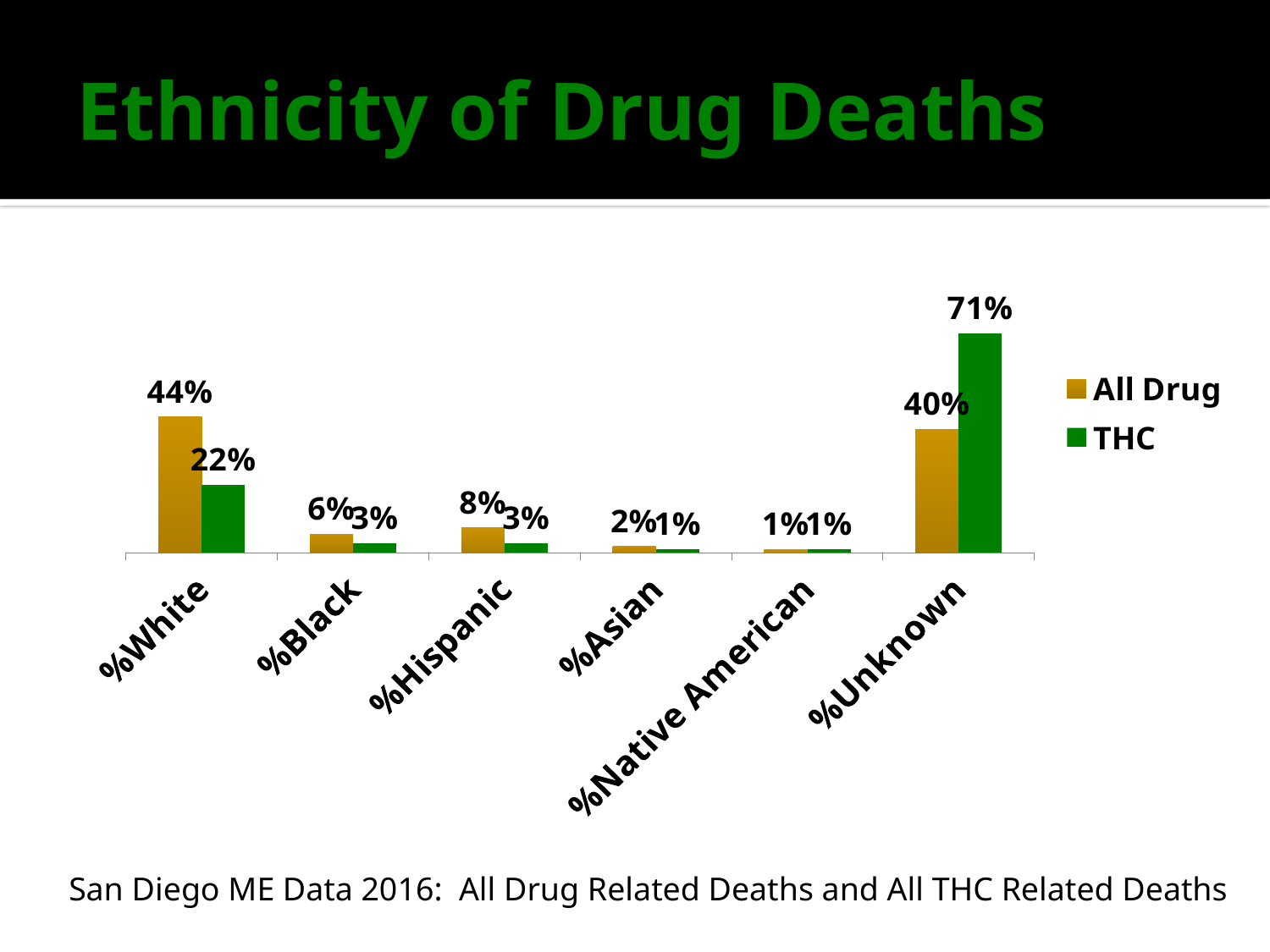
Which is larger for %Black, the All Drug value or the THC value? All Drug Which category has the highest THC value? %Unknown How many series does the legend list? 2 What is the All Drug value for %Asian? 2% What is the difference between the All Drug and THC values for %White? 22% What is the All Drug value for %White? 44% How many ethnicity categories are shown on the x axis? 6 What kind of chart is shown on the slide? Bar chart What is the THC value for %Hispanic? 3% What is the THC value for %Unknown? 71% Which category has the lowest All Drug value? %Native American What is the difference between the THC and All Drug values for %Unknown? 31%